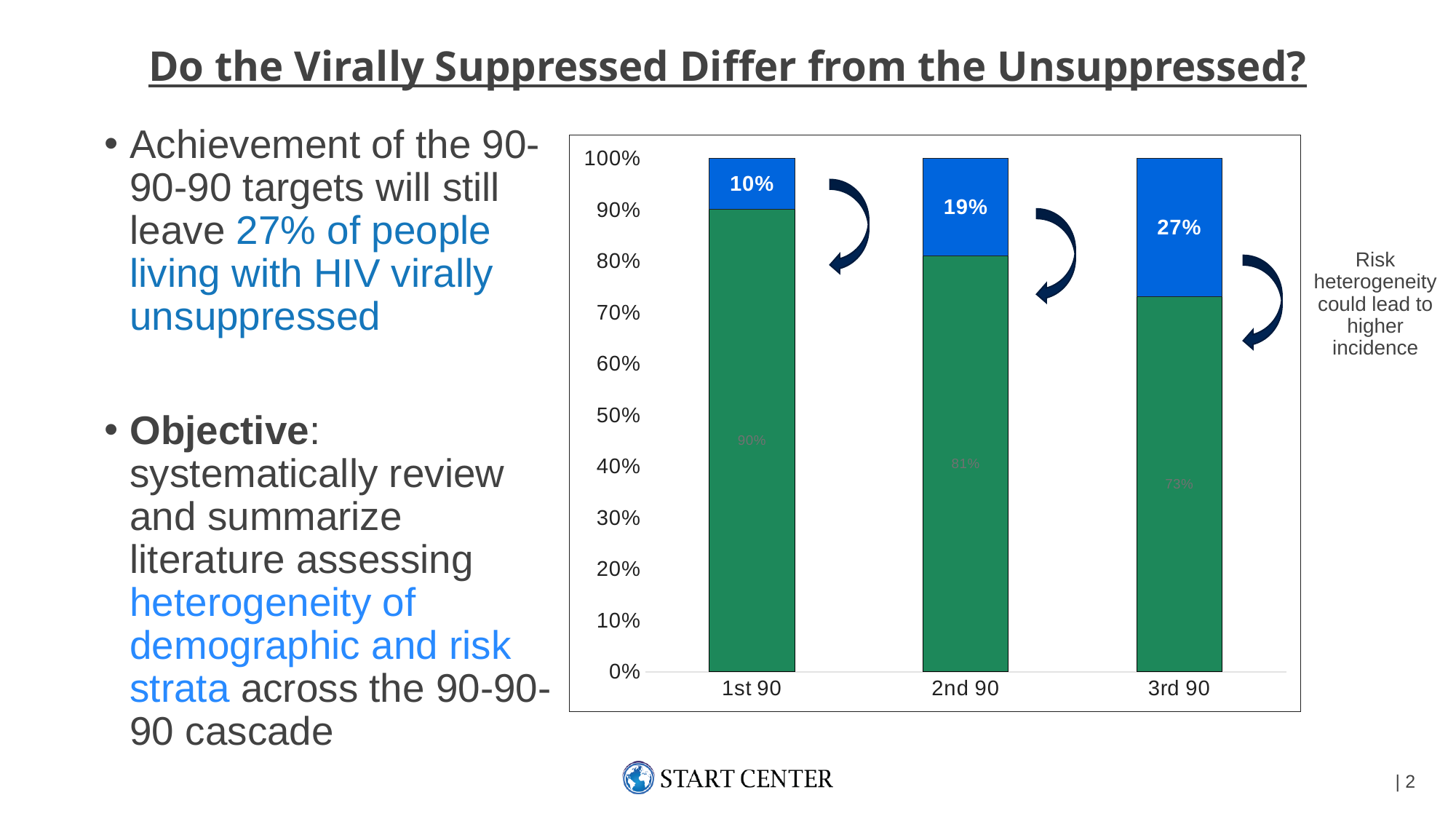
What is the difference between the blue segment values for the 3rd 90 and the 1st 90 bars? 17% What is the value of the blue segment for the 1st 90 bar? 10% Which category has the largest blue segment? 3rd 90 Do the blue segment values rise or fall from 1st 90 to 3rd 90? Rise What is the value of the blue segment for the 2nd 90 bar? 19% What is the value of the green segment for the 1st 90 bar? 90% What kind of chart is shown on the slide? Stacked bar chart Which category has the smallest blue segment? 1st 90 How many categories are shown on the x axis of the chart? 3 Is the green segment for the 2nd 90 bar greater or less than 80%? greater What is the value of the green segment for the 3rd 90 bar? 73% What is the value of the blue segment for the 3rd 90 bar? 27%